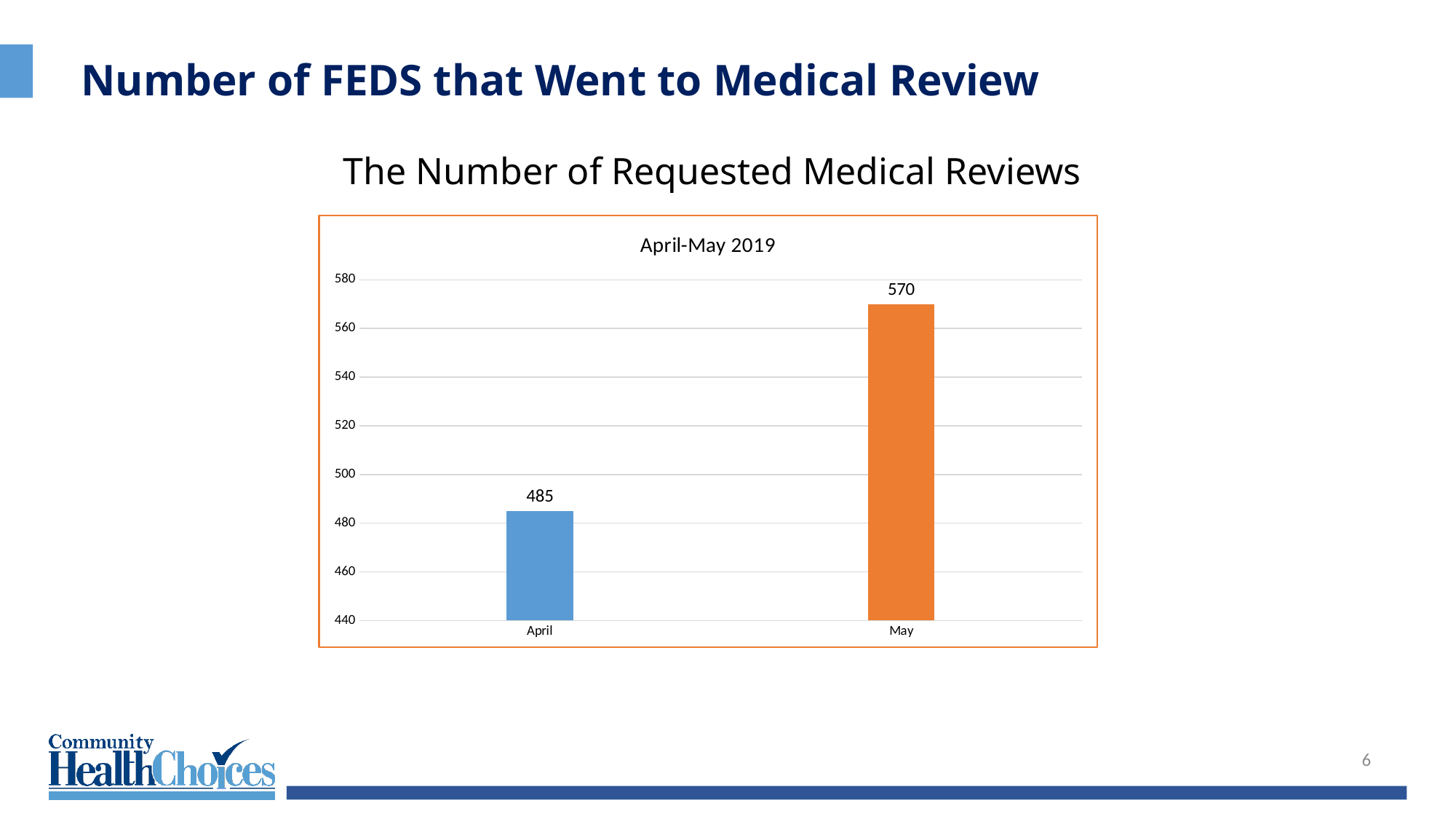
What kind of chart is shown on the slide? bar chart Which month has the highest value? May Is the value for May greater or less than 560? greater What is the title shown inside the chart area? April-May 2019 Is the value for April greater or less than 500? less What is the value for May? 570 How many months are shown on the chart? 2 What is the difference between the values for May and April? 85 Do the values rise or fall from April to May? rise Which is larger, the value for April or the value for May? May What is the value for April? 485 Which month has the lowest value? April